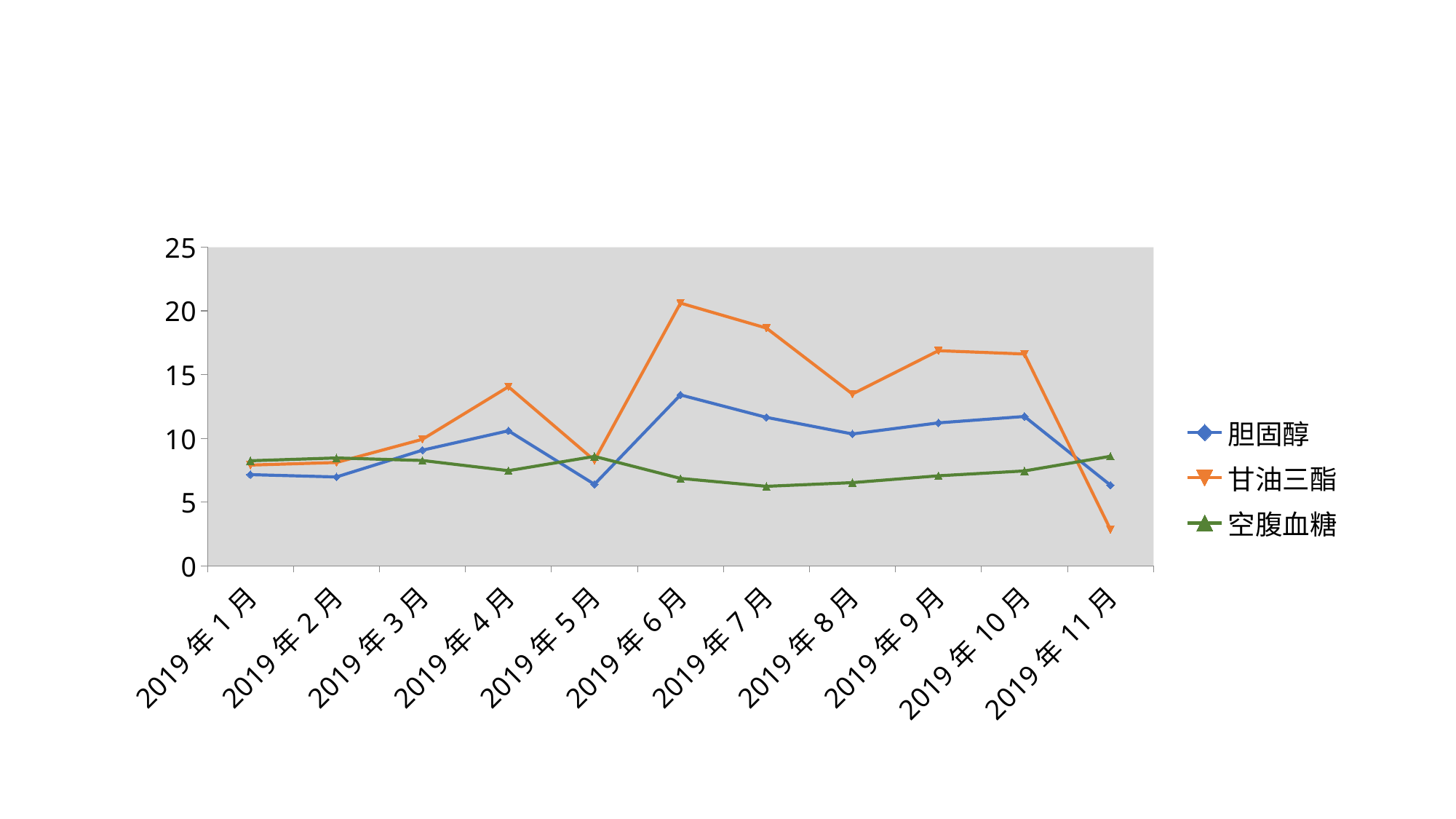
What kind of chart is shown on the slide? line chart Does the 甘油三酯 line rise or fall from 2019年10月 to 2019年11月? fall How many series does the legend list? 3 In which month does 甘油三酯 reach its lowest value? 2019年11月 In 2019年6月, which series has the larger value, 甘油三酯 or 胆固醇? 甘油三酯 In which month does 胆固醇 reach its highest value? 2019年6月 How many months are plotted along the x axis? 11 Is the value for 甘油三酯 in 2019年6月 greater or less than 15? greater Is the value for 空腹血糖 in 2019年7月 greater or less than 10? less In which month does 甘油三酯 reach its highest value? 2019年6月 Is the value for 胆固醇 in 2019年11月 greater or less than 10? less In 2019年11月, which series has the larger value, 空腹血糖 or 甘油三酯? 空腹血糖